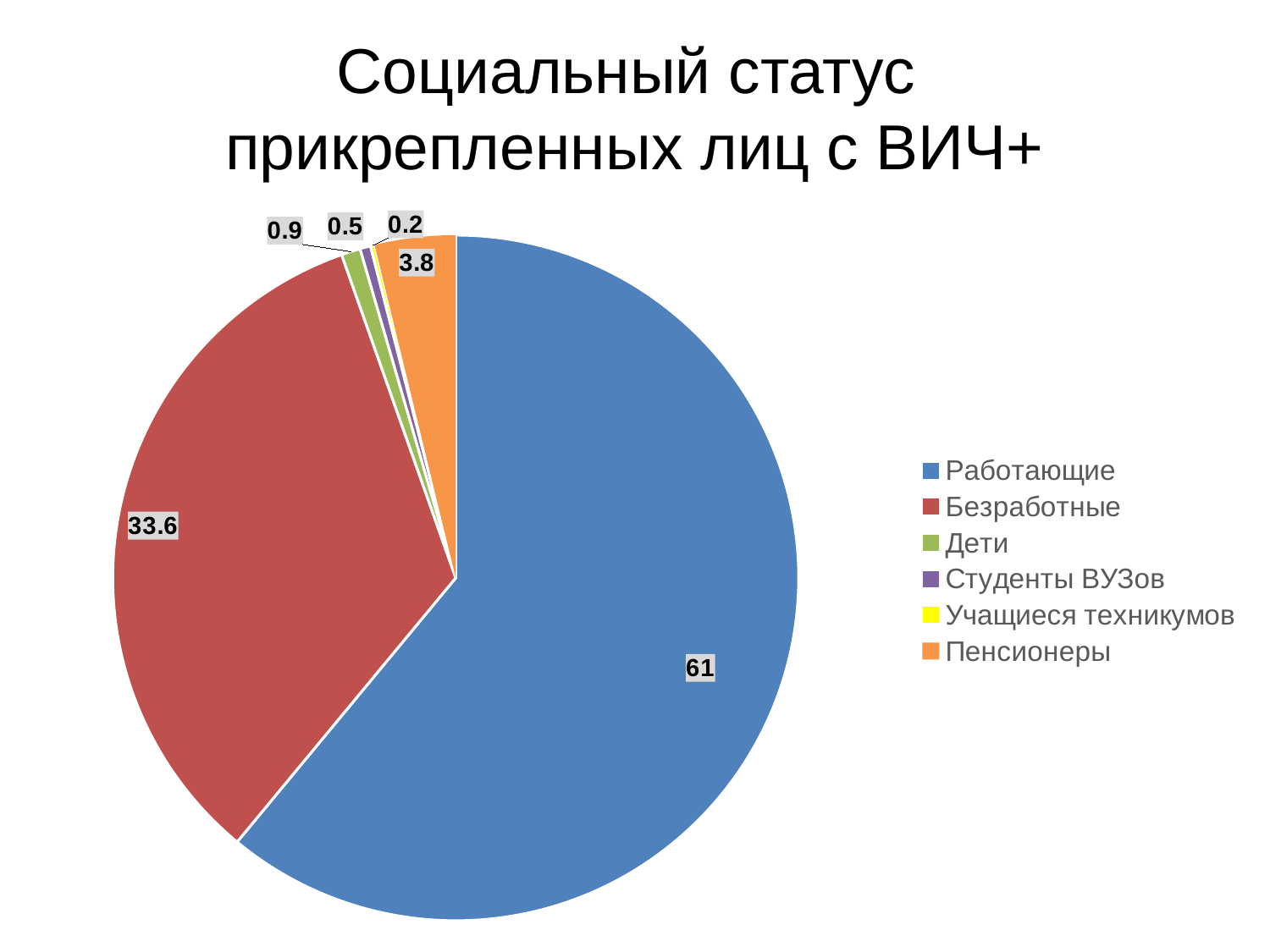
What is the value for Работающие? 61 What is the title of the chart? Социальный статус прикрепленных лиц с ВИЧ+ Which is larger, the value for Пенсионеры or the value for Дети? Пенсионеры What is the value for Учащиеся техникумов? 0.2 What is the value for Дети? 0.9 What is the difference between the values for Работающие and Безработные? 27.4 Which category has the smallest slice? Учащиеся техникумов How many categories does the legend list? 6 Which category has the largest slice? Работающие What is the value for Пенсионеры? 3.8 What is the value for Безработные? 33.6 What type of chart is shown on the slide? pie chart